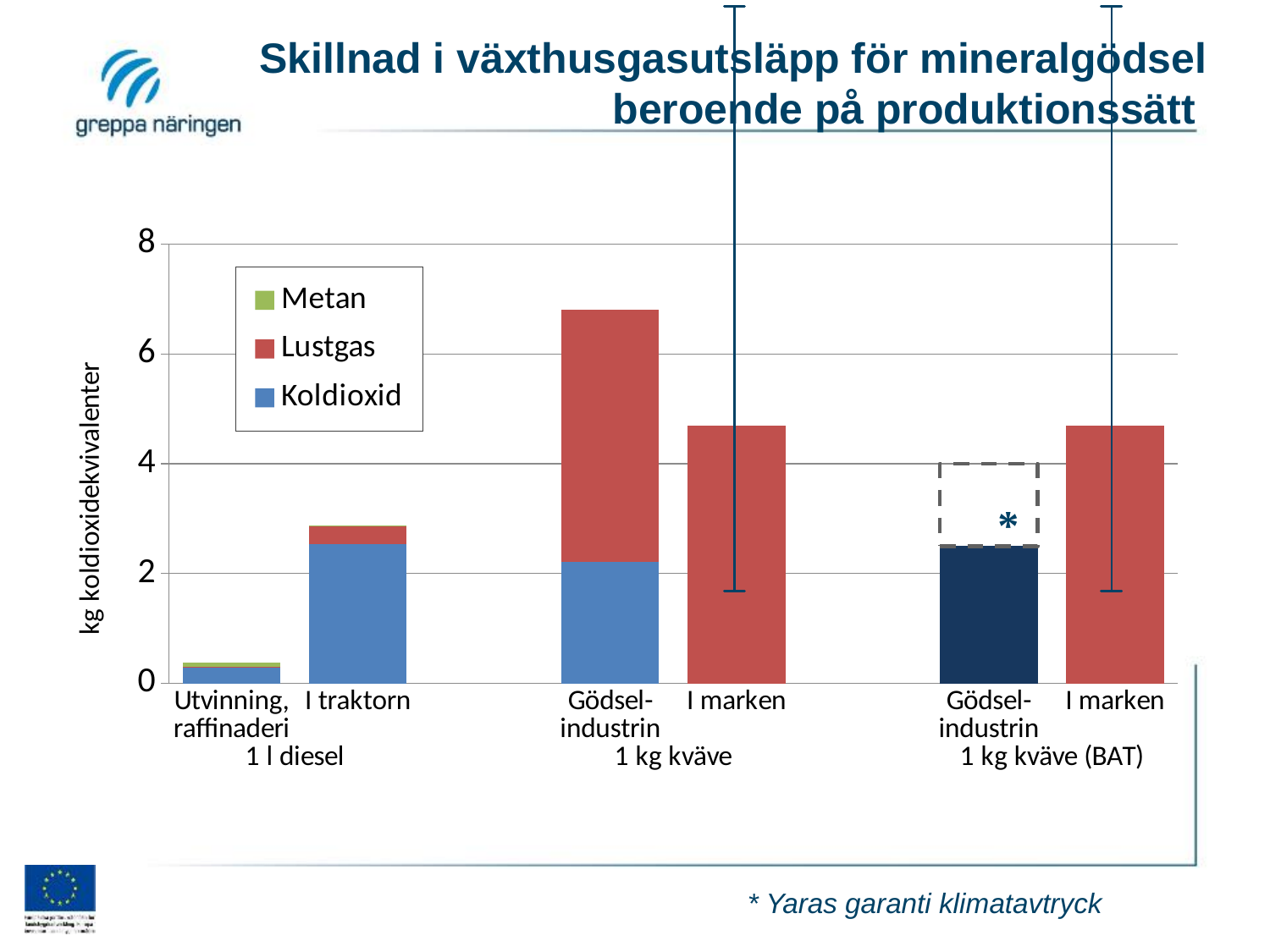
How many bars are plotted in the chart? 6 What is the label on the vertical axis? kg koldioxidekvivalenter Which bar is the lowest in the chart? Utvinning, raffinaderi Is the value for I marken under 1 kg kväve greater or less than 4? greater Is the total value for I traktorn greater or less than 2? greater Is the value for Utvinning, raffinaderi greater or less than 2? less How many series does the legend list? 3 Which bar is the highest in the chart? Gödsel-industrin (1 kg kväve) Which colour represents Lustgas in the legend? red Which is larger: the bar for I traktorn or the bar for Gödsel-industrin under 1 kg kväve? Gödsel-industrin (1 kg kväve) What kind of chart is shown on the slide? bar chart